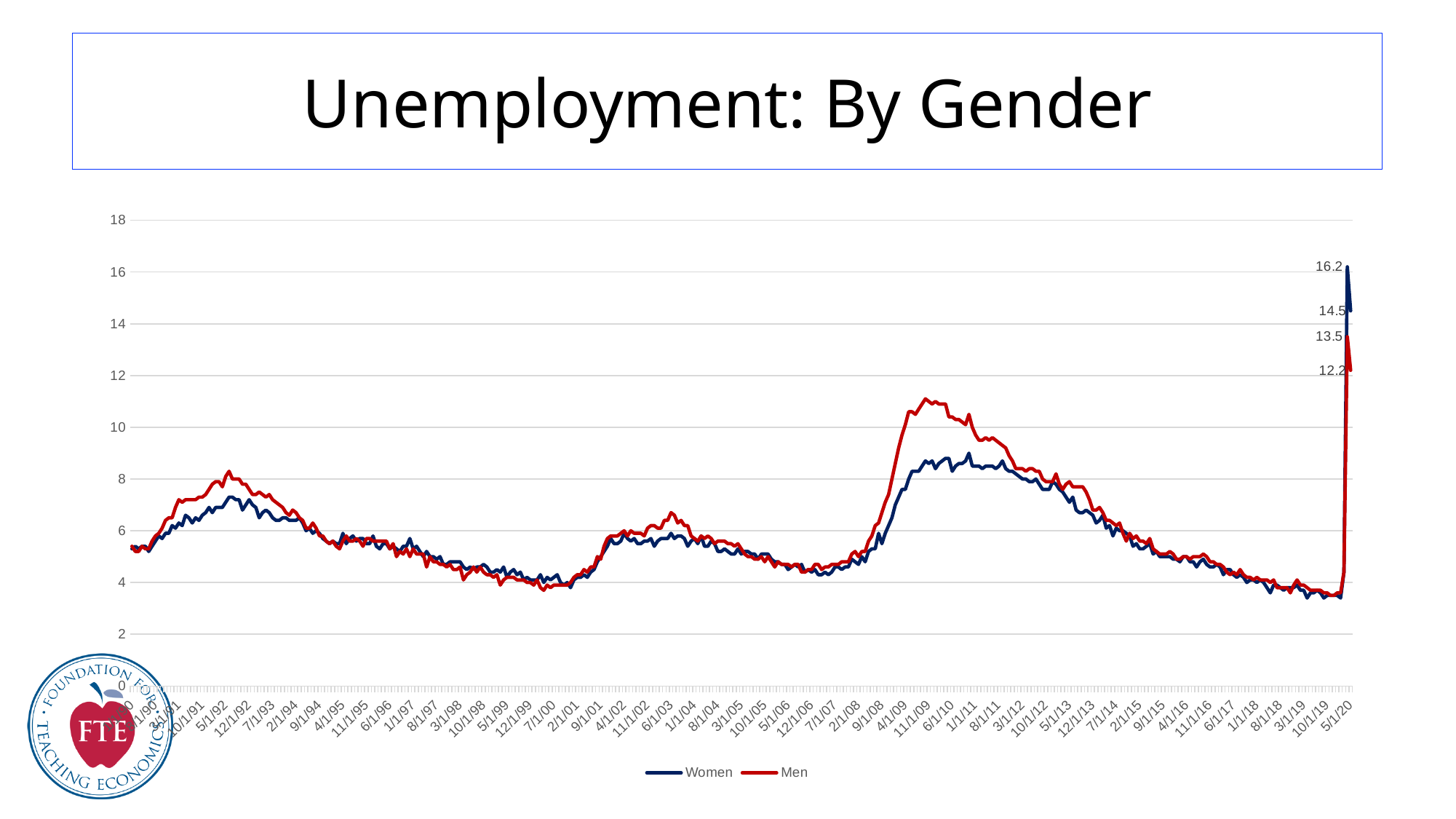
What is the difference between the last labeled values for Women (14.5) and Men (12.2)? 2.3 What is the highest labeled value for the Men series? 13.5 What kind of chart is shown on the slide? line chart What is the last labeled value for the Women series? 14.5 Is the value for Men around 11/1/09 greater or less than 10? greater Is the value for Women around 11/1/09 greater or less than 10? less What is the difference between the peak labeled value for Women (16.2) and the peak labeled value for Men (13.5)? 2.7 What are the two series named in the legend? Women and Men How many series does the legend list? 2 What is the highest labeled value for the Women series? 16.2 What is the last labeled value for the Men series? 12.2 Which series reaches the higher value at the far right of the chart in 2020, Women or Men? Women